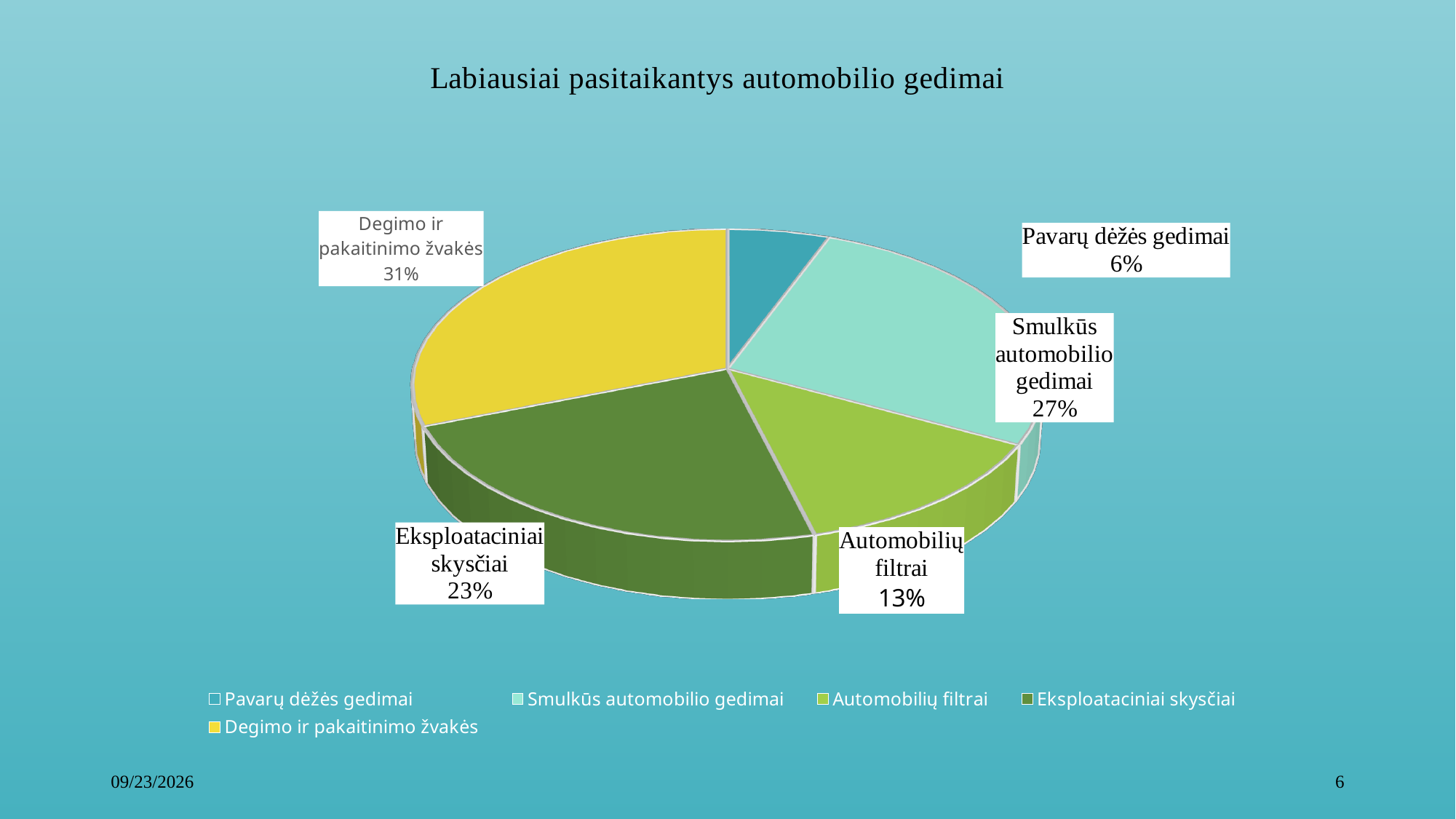
Which is larger: Eksploataciniai skysčiai or Smulkūs automobilio gedimai? Smulkūs automobilio gedimai What share of the pie does Pavarų dėžės gedimai have? 6% What share of the pie does Eksploataciniai skysčiai have? 23% What share of the pie does Automobilių filtrai have? 13% Which category has the smallest slice of the pie? Pavarų dėžės gedimai How many categories are shown in the pie chart? 5 What kind of chart is shown on the slide? Pie chart What is the difference in percentage points between Smulkūs automobilio gedimai and Automobilių filtrai? 14 Which category has the largest slice of the pie? Degimo ir pakaitinimo žvakės What is the title of the chart? Labiausiai pasitaikantys automobilio gedimai